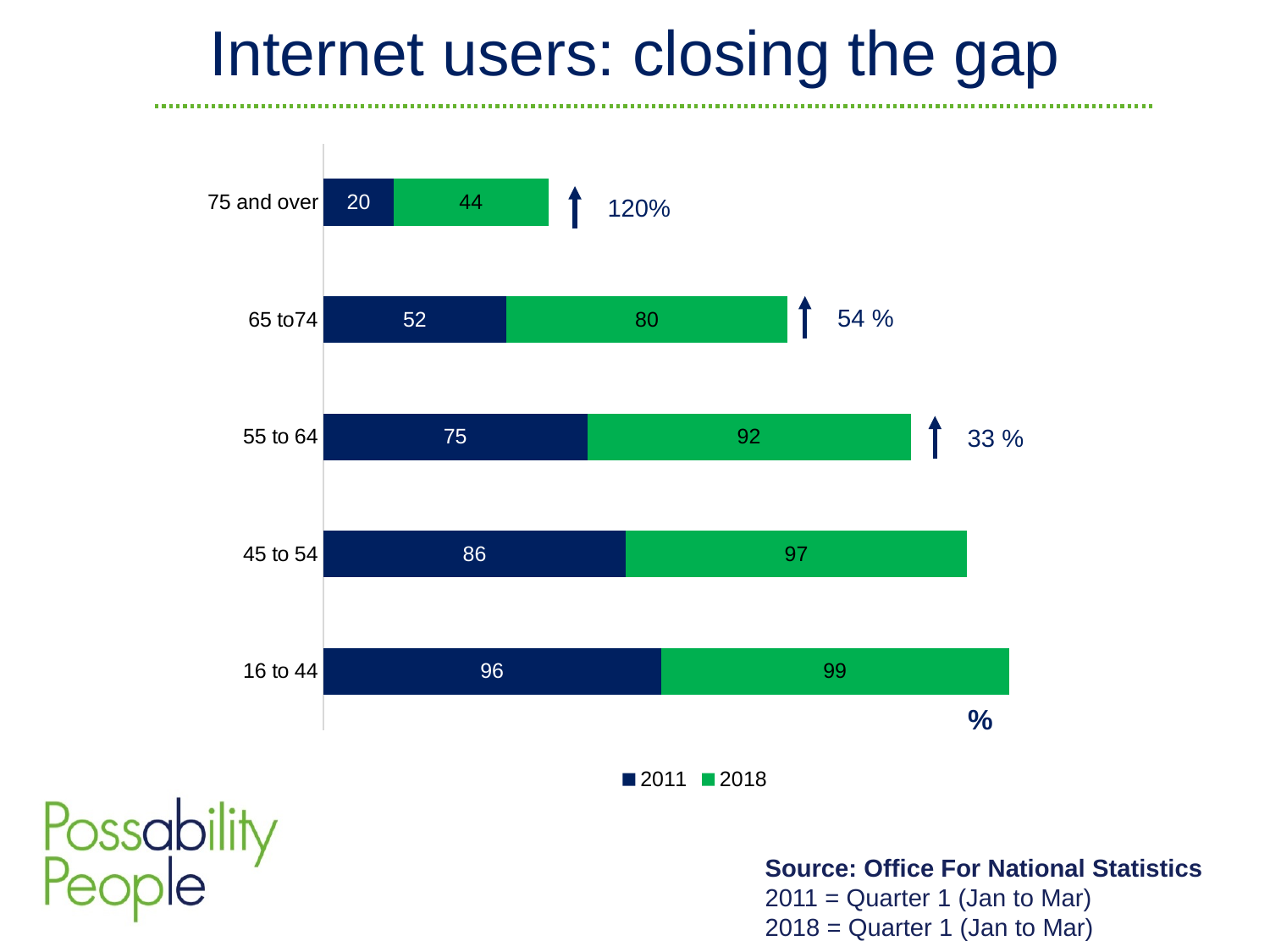
What is the difference between the 2018 and 2011 values for the 55 to 64 age group? 17 Which is larger: the 2011 value for 45 to 54 or the 2018 value for 65 to74? 2011 value for 45 to 54 What is the 2018 value for the 45 to 54 age group? 97 What is the 2011 value for the 75 and over age group? 20 What is the total of the stacked bar for the 16 to 44 age group? 195 Which age group has the highest 2018 value? 16 to 44 How many series does the legend list? 2 What percentage increase is annotated next to the 75 and over bar? 120% What kind of chart is shown on the slide? Stacked bar chart What is the 2018 value for the 65 to74 age group? 80 How many age groups are shown in the chart? 5 Which age group has the lowest 2011 value? 75 and over